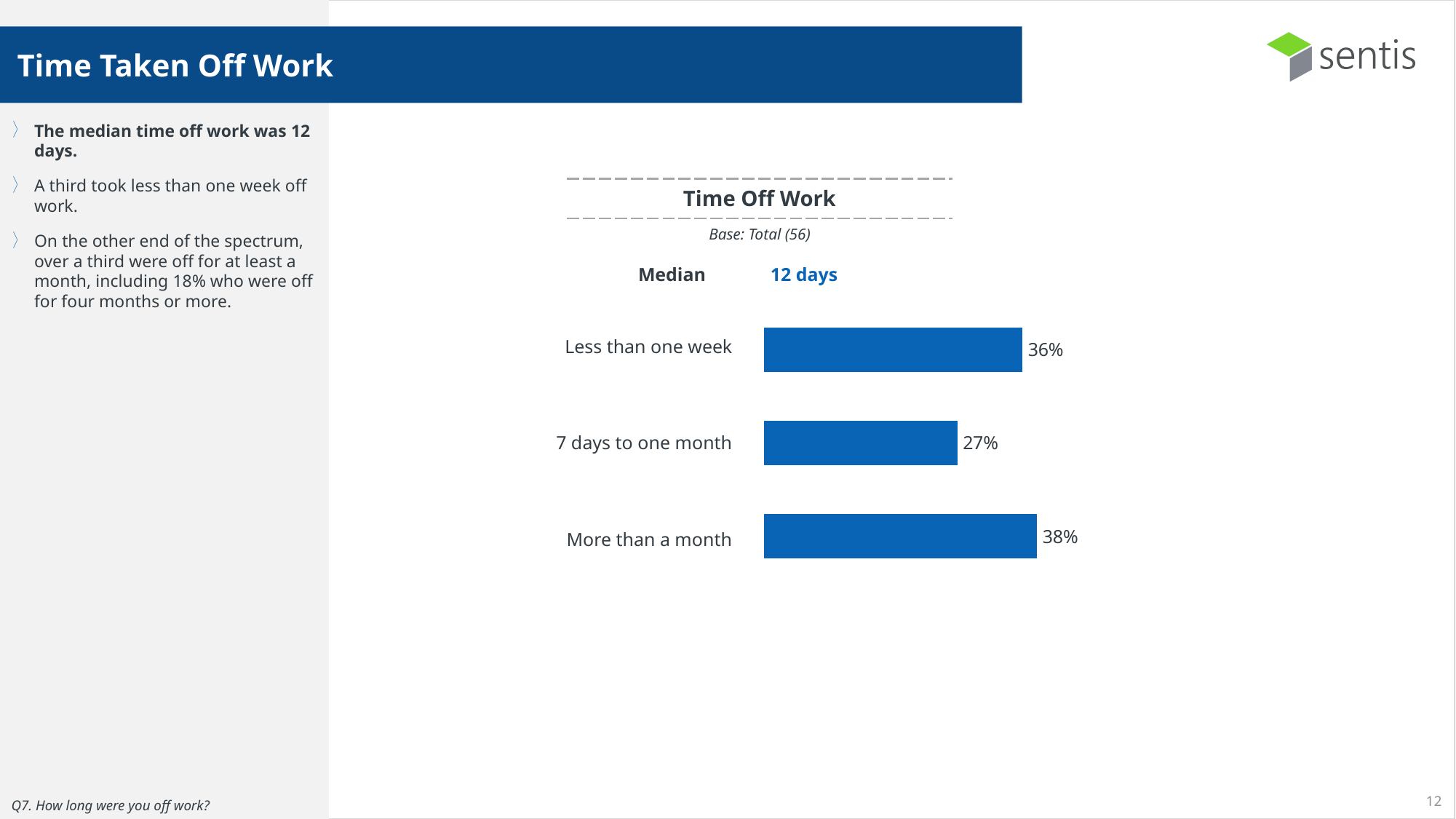
What is the title of the chart? Time Off Work What percentage were off work for more than a month? 38% How many categories are shown in the chart? 3 What median value is shown above the chart? 12 days What percentage took less than one week off work? 36% What is the difference between 'More than a month' and '7 days to one month'? 11 percentage points Which category has the lowest value? 7 days to one month Which category has the highest value? More than a month What kind of chart is shown? Bar chart What is the value for '7 days to one month'? 27% Which is larger: 'Less than one week' or 'More than a month'? More than a month What is the difference between 'Less than one week' and '7 days to one month'? 9 percentage points